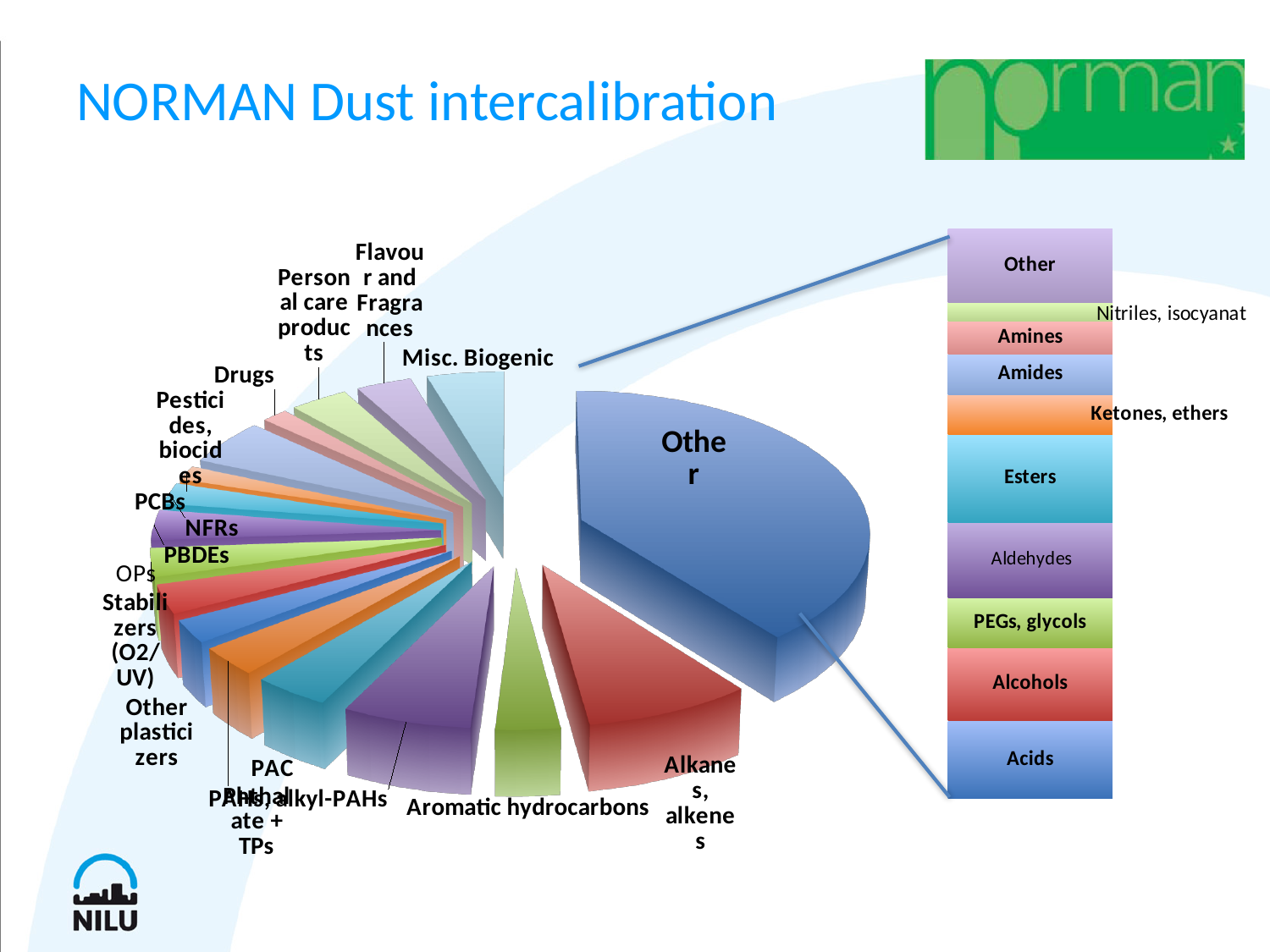
Which segment is at the bottom of the stacked bar on the right? Acids Which is larger in the pie chart, the Other slice or the Alkanes, alkenes slice? Other Which segment of the stacked bar on the right is the smallest? Nitriles, isocyanat Which slice of the pie chart is the largest? Other Which pie slice is broken down into the stacked bar on the right? Other Which is larger in the pie chart, the Aromatic hydrocarbons slice or the PAHs, alkyl-PAHs slice? PAHs, alkyl-PAHs Which is larger in the pie chart, the Alkanes, alkenes slice or the Aromatic hydrocarbons slice? Alkanes, alkenes How many segments make up the stacked bar on the right of the chart? 10 What kind of chart is shown on the slide? pie chart